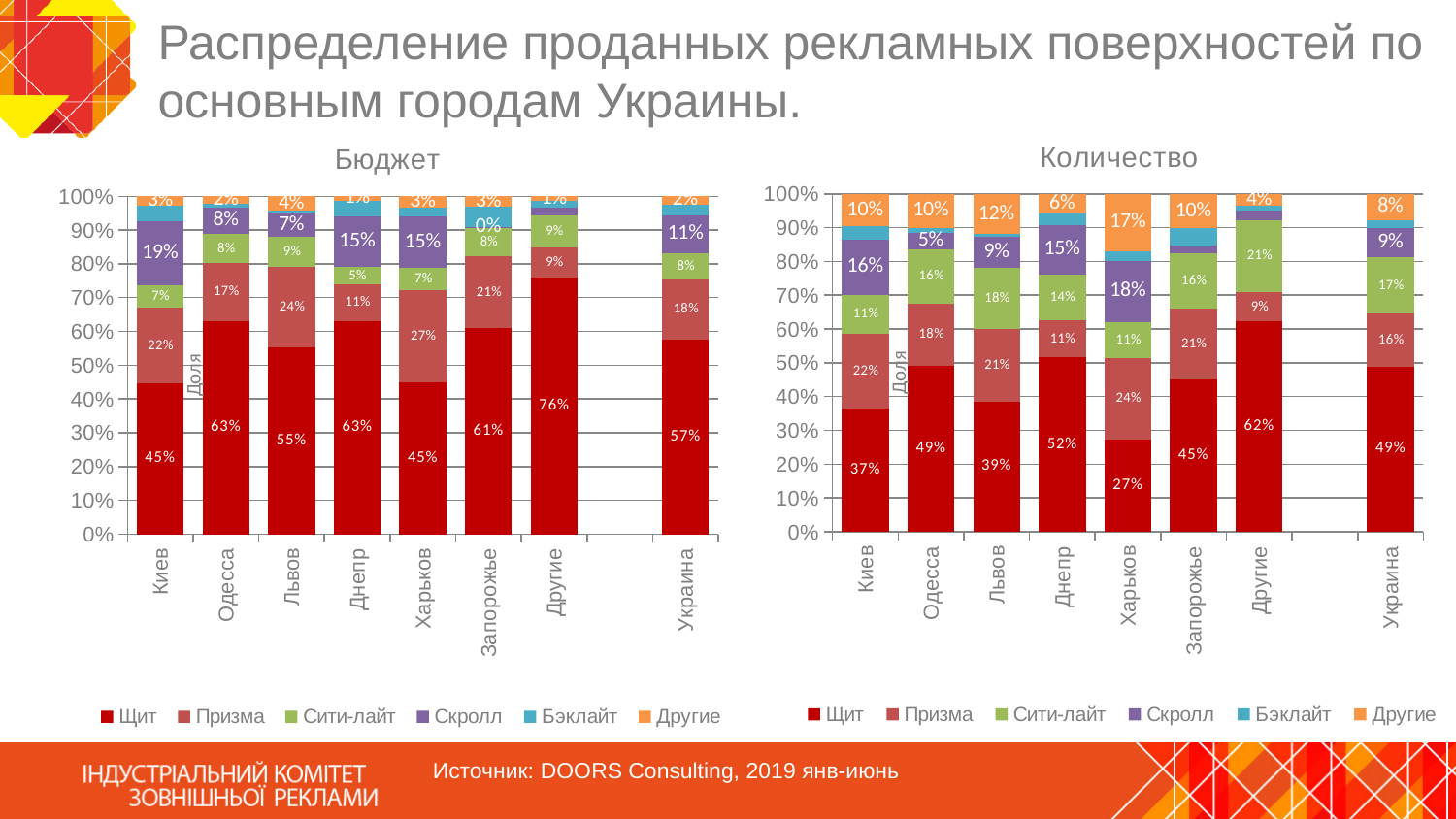
In the "Бюджет" chart, what is the difference between the Щит values for Одесса and Киев? 18% What type of chart is the "Бюджет" chart? Stacked bar chart How many series does the legend of the "Количество" chart list? 6 In the "Бюджет" chart, what is the value of Призма for Львов? 24% In the "Количество" chart, what is the value of Щит for Харьков? 27% What is the title of the chart on the right side of the slide? Количество In the "Количество" chart, what is the value of Другие (top segment) for Харьков? 17% In the "Количество" chart, which is larger: the Щит value for Днепр or for Львов? Днепр In the "Бюджет" chart, which city has the highest Щит share? Другие In the "Бюджет" chart, what is the value of Щит for Киев? 45% How many cities/categories are shown on the x axis of the "Бюджет" chart? 8 In the "Количество" chart, which city has the lowest Щит share? Харьков